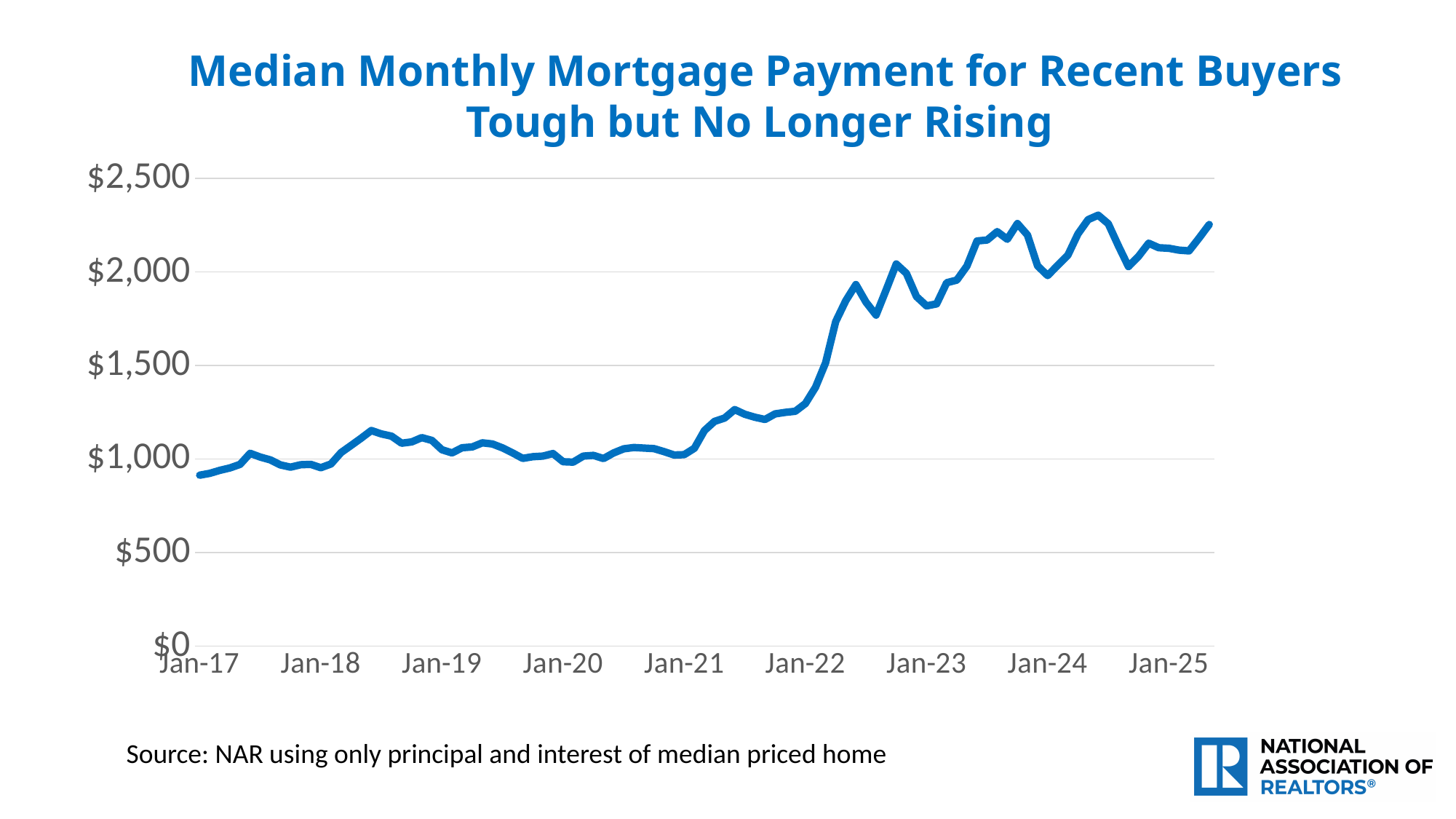
Which is larger, the value at Jan-22 or the value at Jan-19? Jan-22 What kind of chart is shown on the slide? line chart Is the value for Jan-25 greater or less than $2,000? greater Is the highest point on the line greater or less than $2,500? less Is the value for Jan-22 greater or less than $1,500? less How many year labels are shown on the x axis? 9 Which is larger, the value at Jan-25 or the value at Jan-17? Jan-25 Overall, does the median monthly mortgage payment rise or fall from Jan-17 to Jan-25? rise What is the title of the chart? Median Monthly Mortgage Payment for Recent Buyers Tough but No Longer Rising